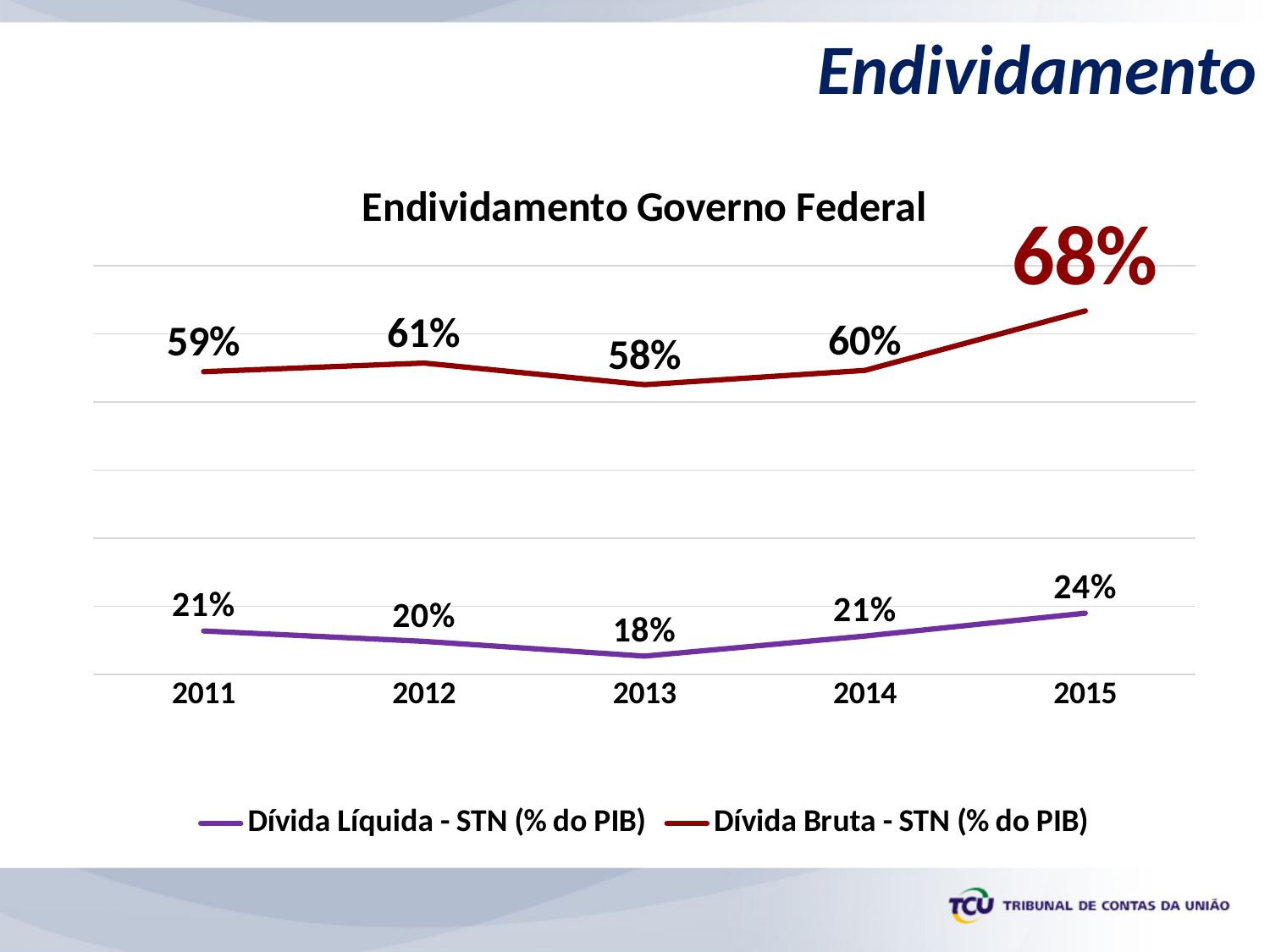
How many years are shown on the x axis? 5 By how much did Dívida Bruta - STN (% do PIB) increase from 2014 to 2015? 8% What is the difference between Dívida Bruta and Dívida Líquida in 2015? 44% What is the title of the chart? Endividamento Governo Federal What is the value of Dívida Bruta - STN (% do PIB) in 2012? 61% How many series does the legend list? 2 What is the value of Dívida Bruta - STN (% do PIB) in 2015? 68% Which is larger: Dívida Líquida in 2011 or Dívida Líquida in 2015? 2015 In which year is Dívida Líquida - STN (% do PIB) lowest? 2013 What is the value of Dívida Líquida - STN (% do PIB) in 2013? 18% What kind of chart is shown on the slide? Line chart In which year is Dívida Bruta - STN (% do PIB) highest? 2015